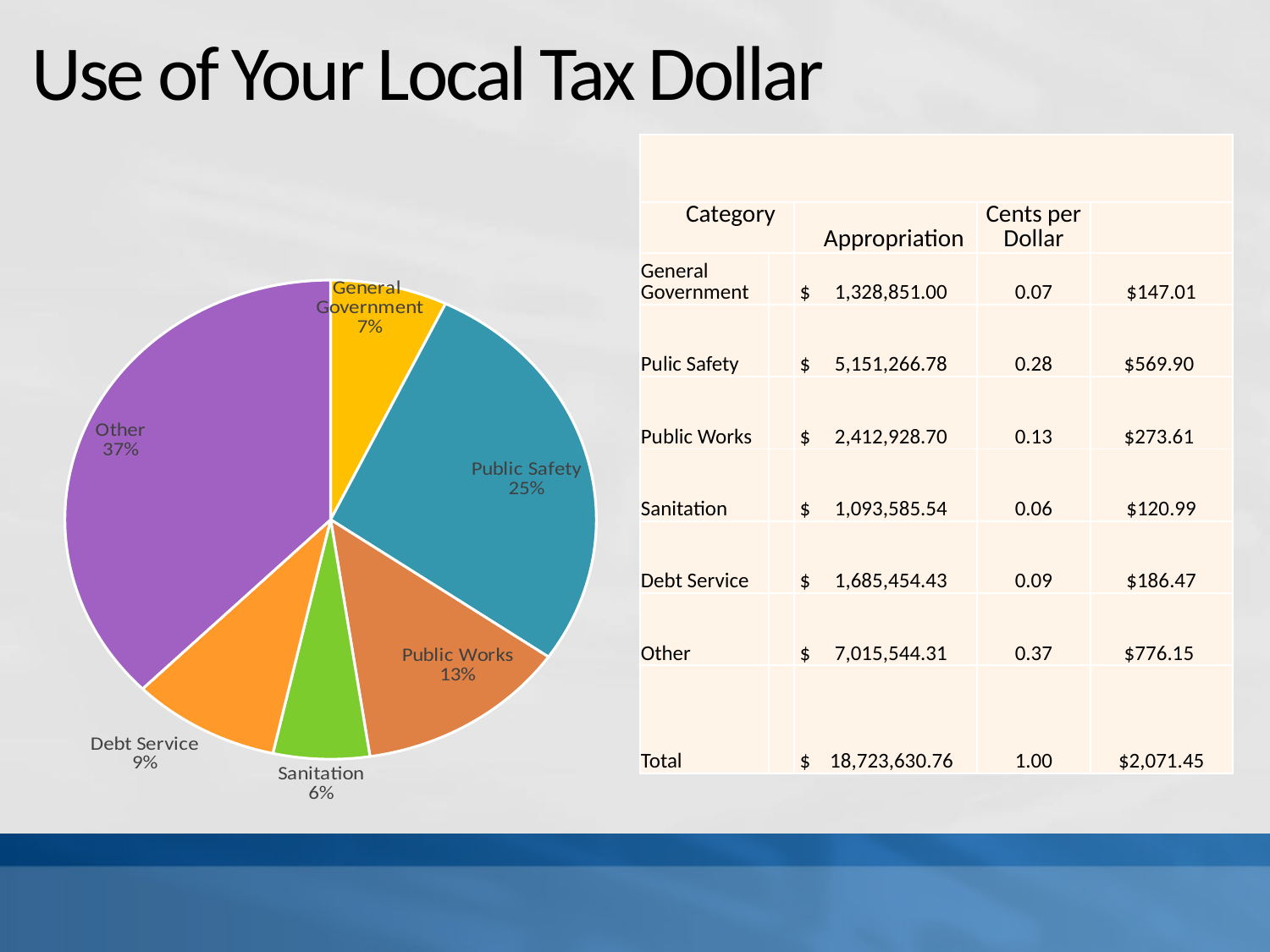
What share of the pie does Public Safety represent? 25% What is the difference in percentage points between Public Safety and Public Works? 12 What kind of chart is shown on the slide? Pie chart What colour is the Other slice of the pie? Purple Which category has the smallest slice of the pie? Sanitation What is the combined percentage of Debt Service and Sanitation? 15% Which slice is larger, Debt Service or General Government? Debt Service How many slices does the pie chart have? 6 What percentage is shown for Sanitation? 6% What is the title of the slide containing the pie chart? Use of Your Local Tax Dollar Which category has the largest slice of the pie? Other What percentage is shown for the Other slice? 37%